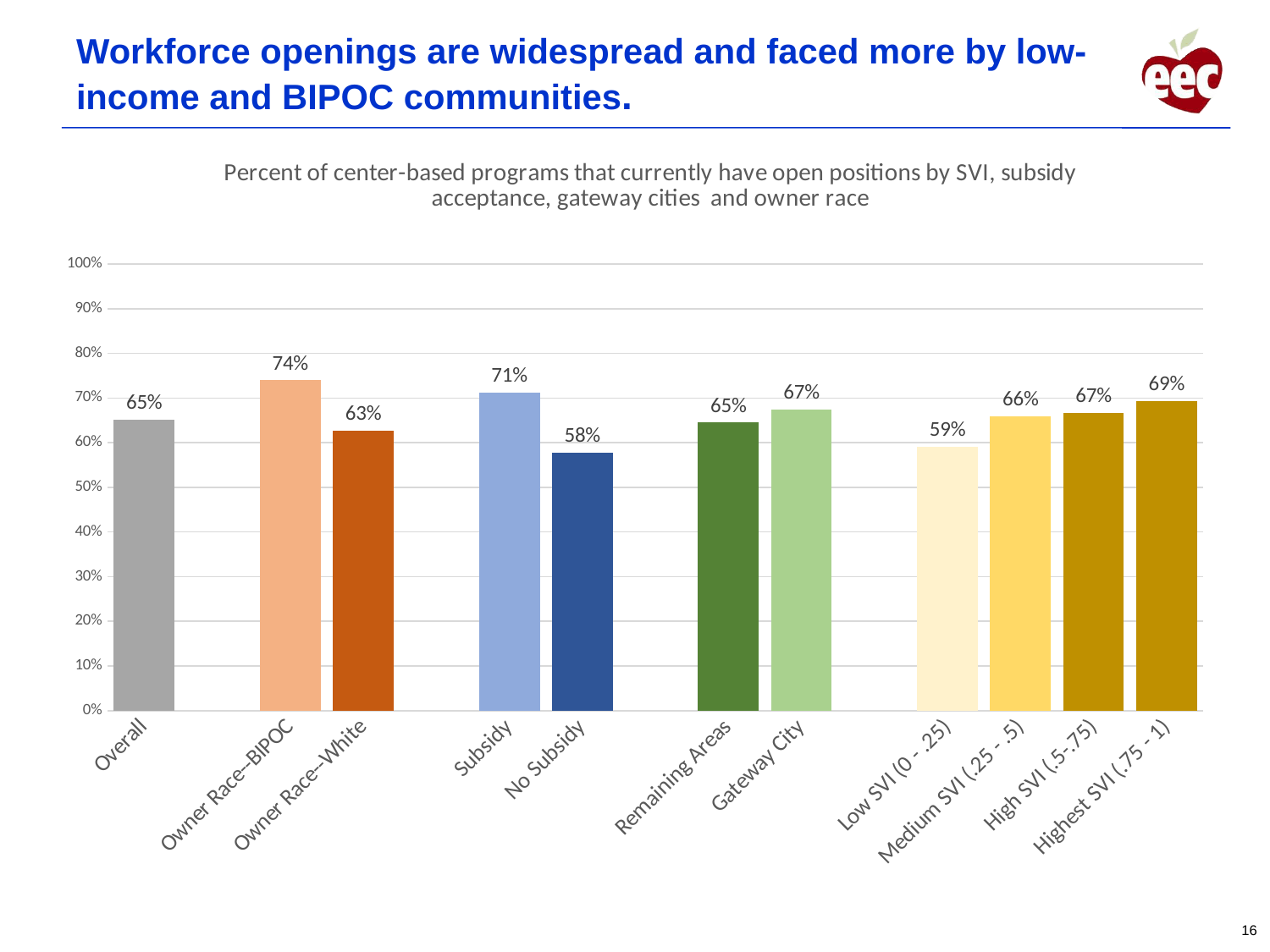
Do the values rise or fall across the four SVI categories from Low SVI to Highest SVI? Rise What kind of chart is shown on the slide? Bar chart What is the value for Owner Race--BIPOC? 74% How many categories are shown on the chart? 11 Which category has the highest value? Owner Race--BIPOC What is the value for No Subsidy? 58% Which is larger, the value for Highest SVI (.75 - 1) or the value for Low SVI (0 - .25)? Highest SVI (.75 - 1) What is the difference between the values for Subsidy and No Subsidy? 13% Which category has the lowest value? No Subsidy What is the difference between the values for Owner Race--BIPOC and Owner Race--White? 11% What is the value for Gateway City? 67% What is the value for Low SVI (0 - .25)? 59%